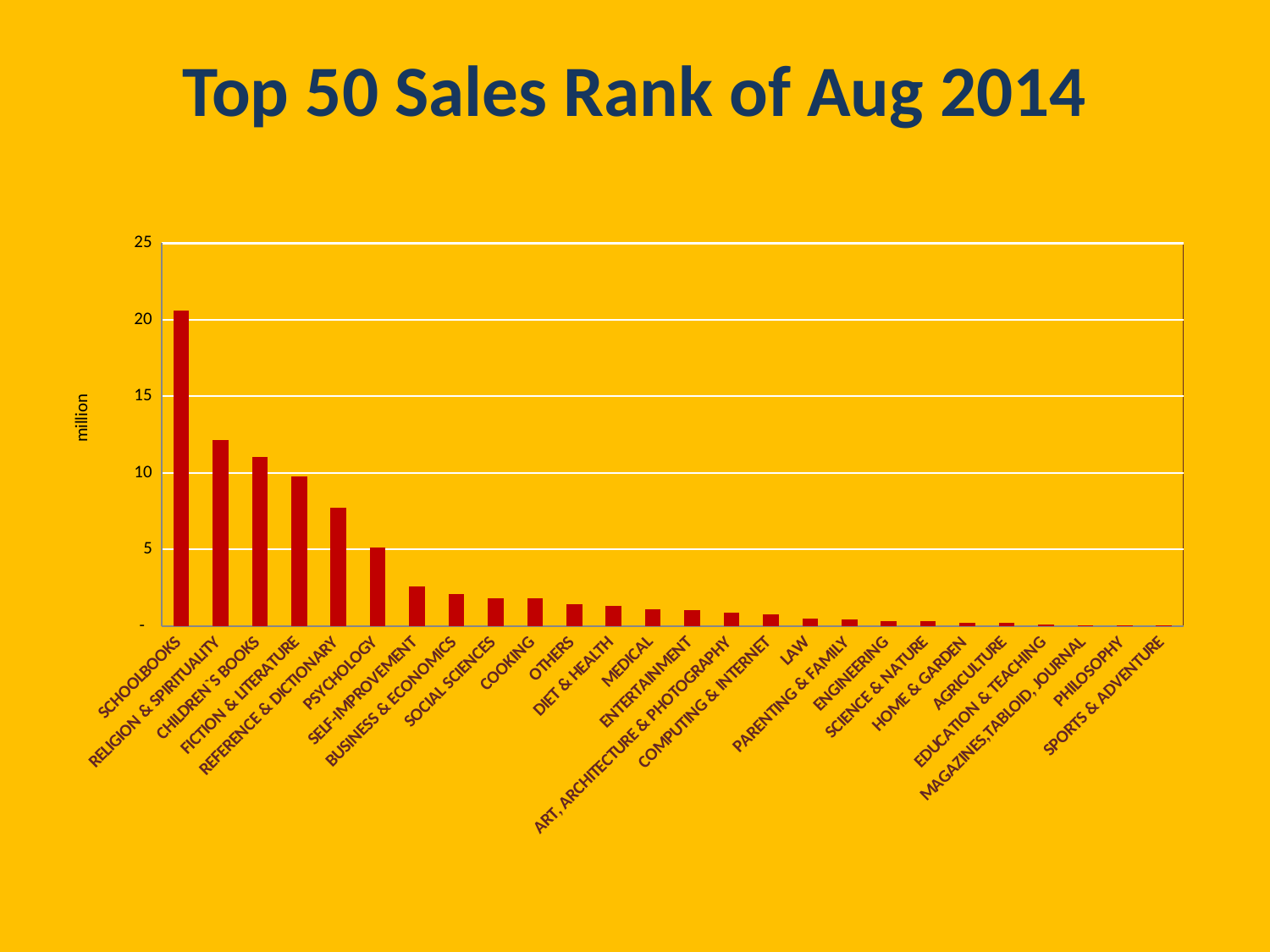
Is the value for RELIGION & SPIRITUALITY greater or less than 10? greater Which is larger, the value for SCHOOLBOOKS or the value for RELIGION & SPIRITUALITY? SCHOOLBOOKS Is the value for REFERENCE & DICTIONARY greater or less than 5? greater Is the value for SCHOOLBOOKS greater or less than 15? greater How many categories are plotted in the chart? 26 What unit is shown on the vertical axis label? million Which is larger, the value for REFERENCE & DICTIONARY or the value for PSYCHOLOGY? REFERENCE & DICTIONARY Which category has the highest value? SCHOOLBOOKS What is the title of the chart? Top 50 Sales Rank of Aug 2014 Do the values rise or fall moving from left to right along the x axis? fall What kind of chart is shown on the slide? bar chart